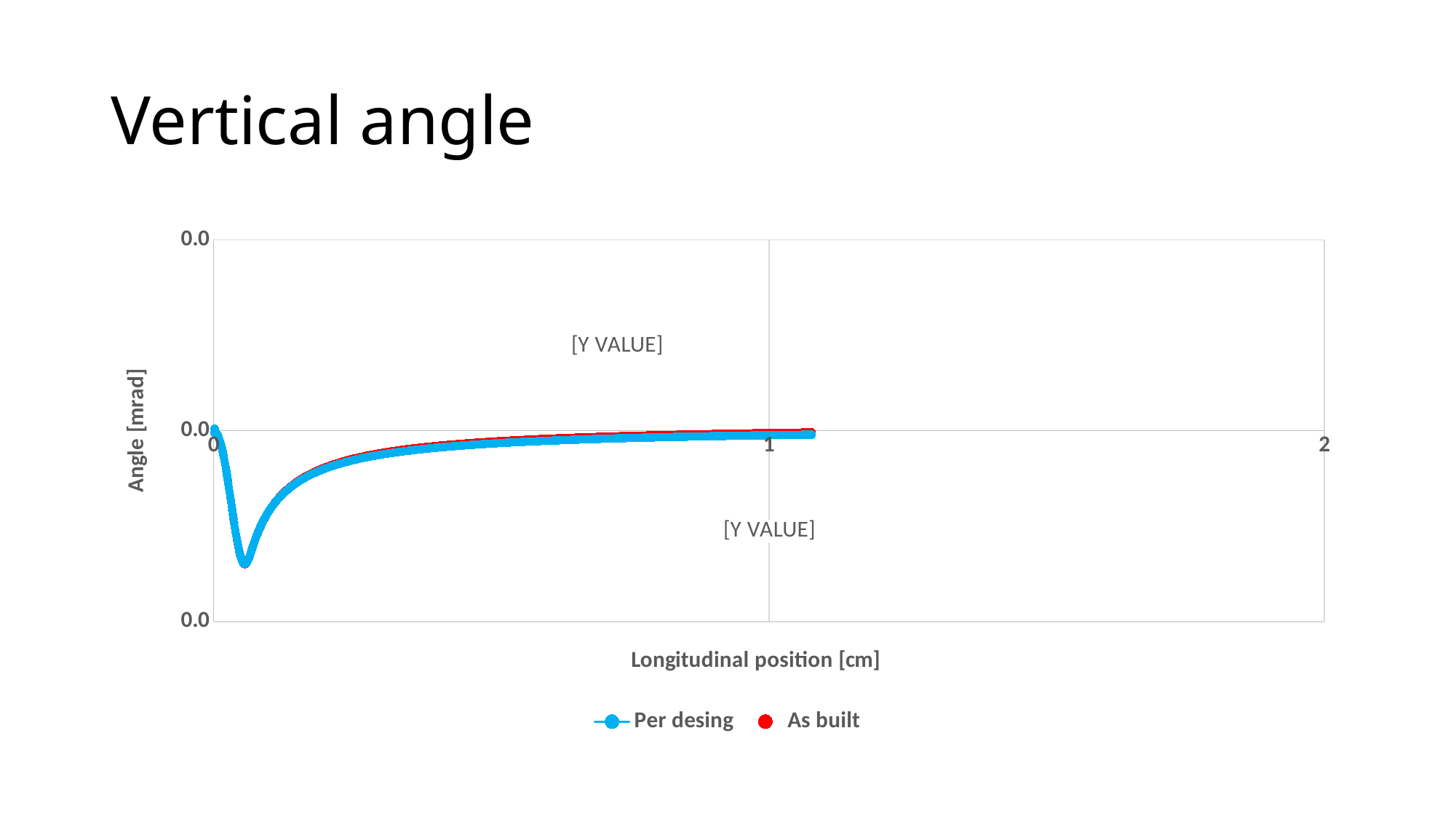
After reaching its minimum, does the Per desing series rise or fall as the longitudinal position increases? rise Is the largest longitudinal position plotted for the As built series greater or less than 1 cm? greater What kind of chart is shown on the slide? line chart Starting from a longitudinal position of 0, does the Per desing series initially rise or fall? fall Is the largest longitudinal position plotted for the Per desing series greater or less than 2 cm? less How many series does the legend list? 2 What are the two series named in the legend? Per desing, As built What is the title of the vertical axis? Angle [mrad] Is the longitudinal position at which the Per desing series reaches its minimum greater or less than 1 cm? less